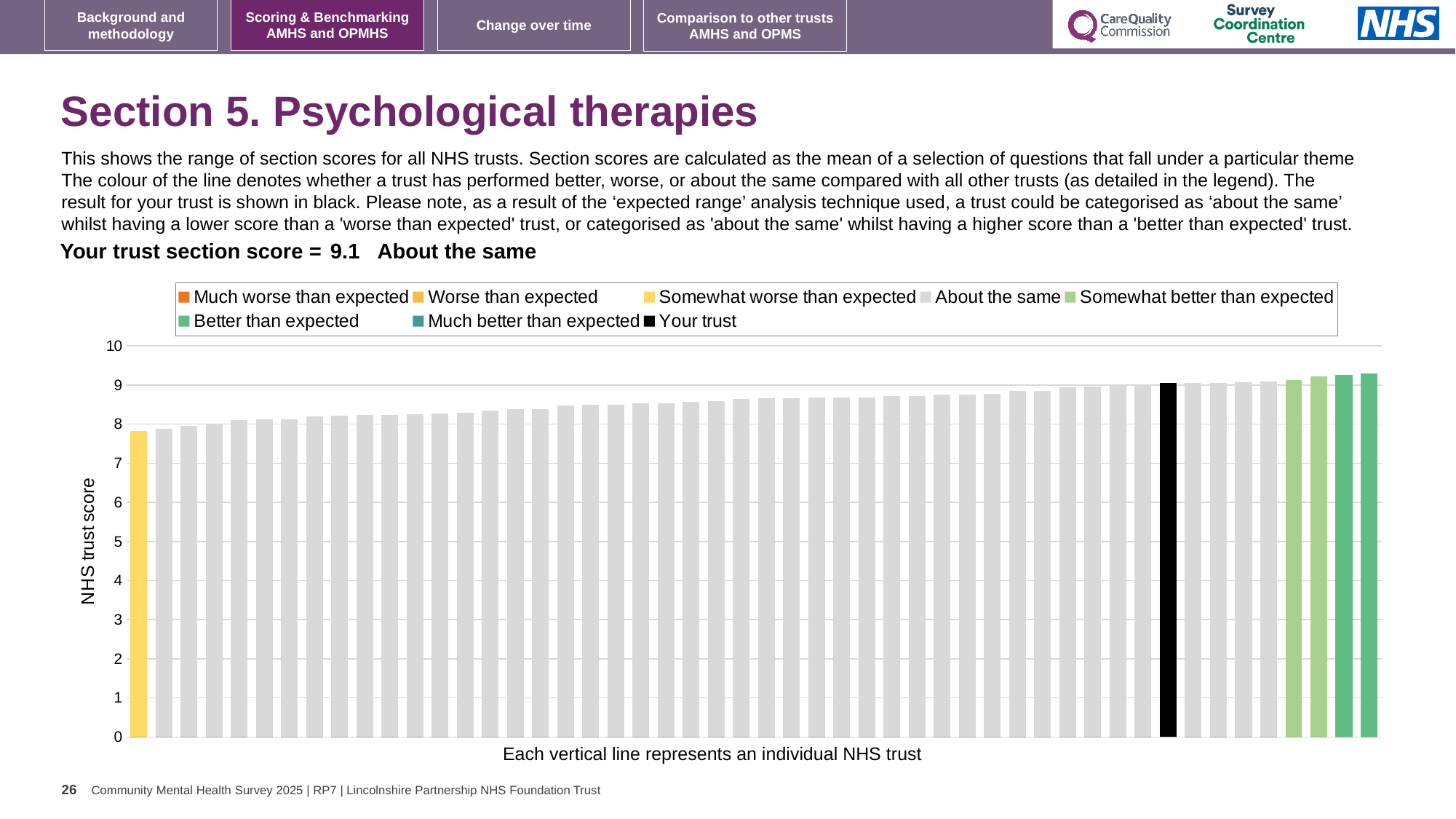
Is the value of the rightmost (highest) bar greater or less than 10? less Do the bar values rise or fall from left to right along the x axis? rise What colour is the bar representing your trust? black What kind of chart is shown on the slide? bar chart Is the value of the leftmost (lowest) bar greater or less than 9? less Is the value of the black 'Your trust' bar greater or less than 8? greater What is the section score for your trust shown on the slide? 9.1 How many entries does the chart legend list? 8 How many bars are coloured yellow (Somewhat worse than expected)? 1 How many bars are coloured green (Somewhat better than expected or Better than expected)? 4 What is the label on the y axis of the chart? NHS trust score Which category is your trust placed in for this section? About the same